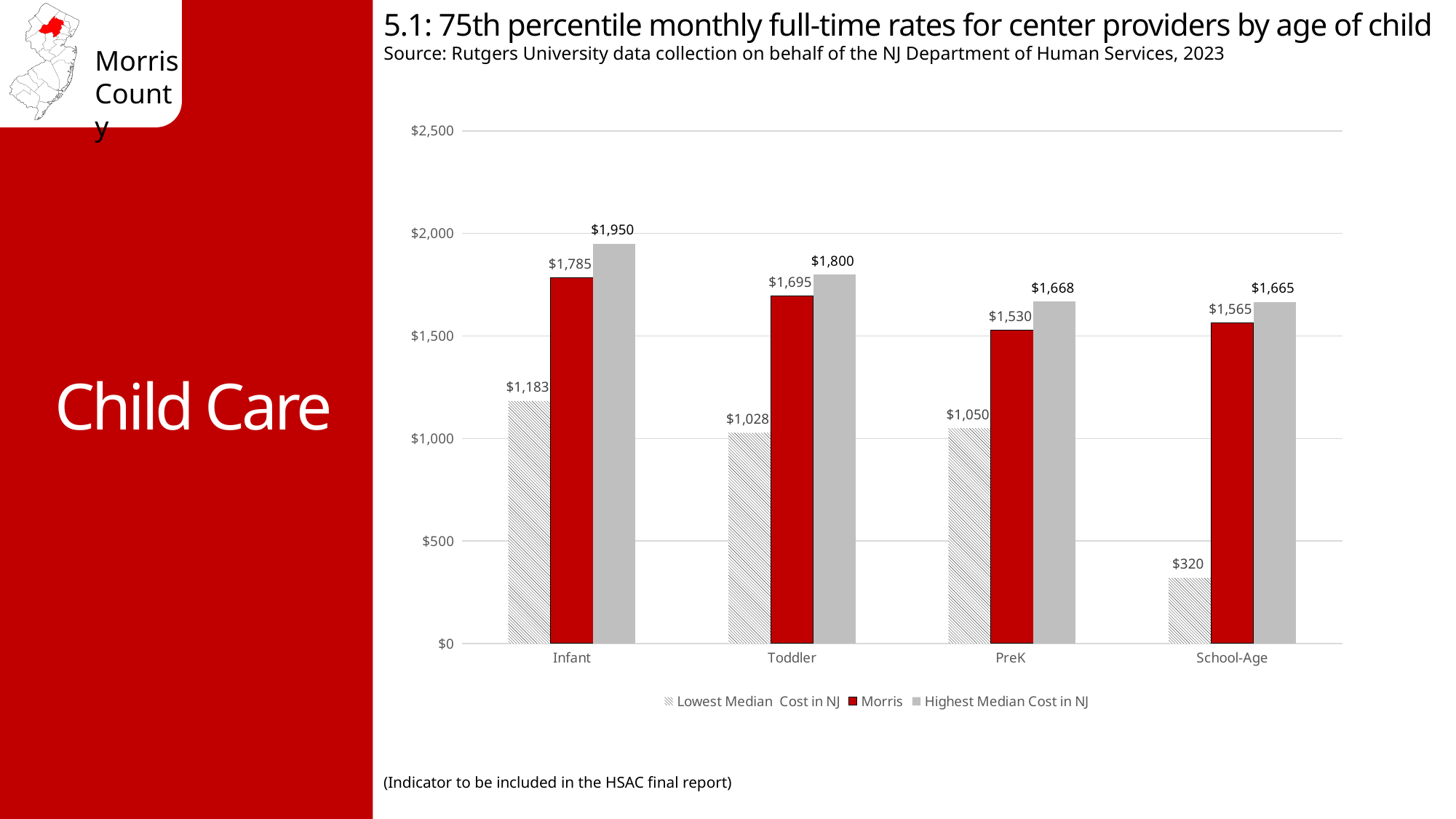
What is the difference between the Highest Median Cost in NJ and the Morris value for Infant? $165 Which is larger for PreK: the Morris value or the Lowest Median Cost in NJ value? Morris Which age category has the lowest Lowest Median Cost in NJ value? School-Age What is the Highest Median Cost in NJ for Toddler? $1,800 What is the Lowest Median Cost in NJ for School-Age? $320 Is the Morris value for School-Age greater or less than $1,500? greater How many series does the legend list? 3 What is the Morris value for Infant? $1,785 What kind of chart is shown on the slide? Bar chart How many age categories are shown on the x axis? 4 Which age category has the highest Morris value? Infant